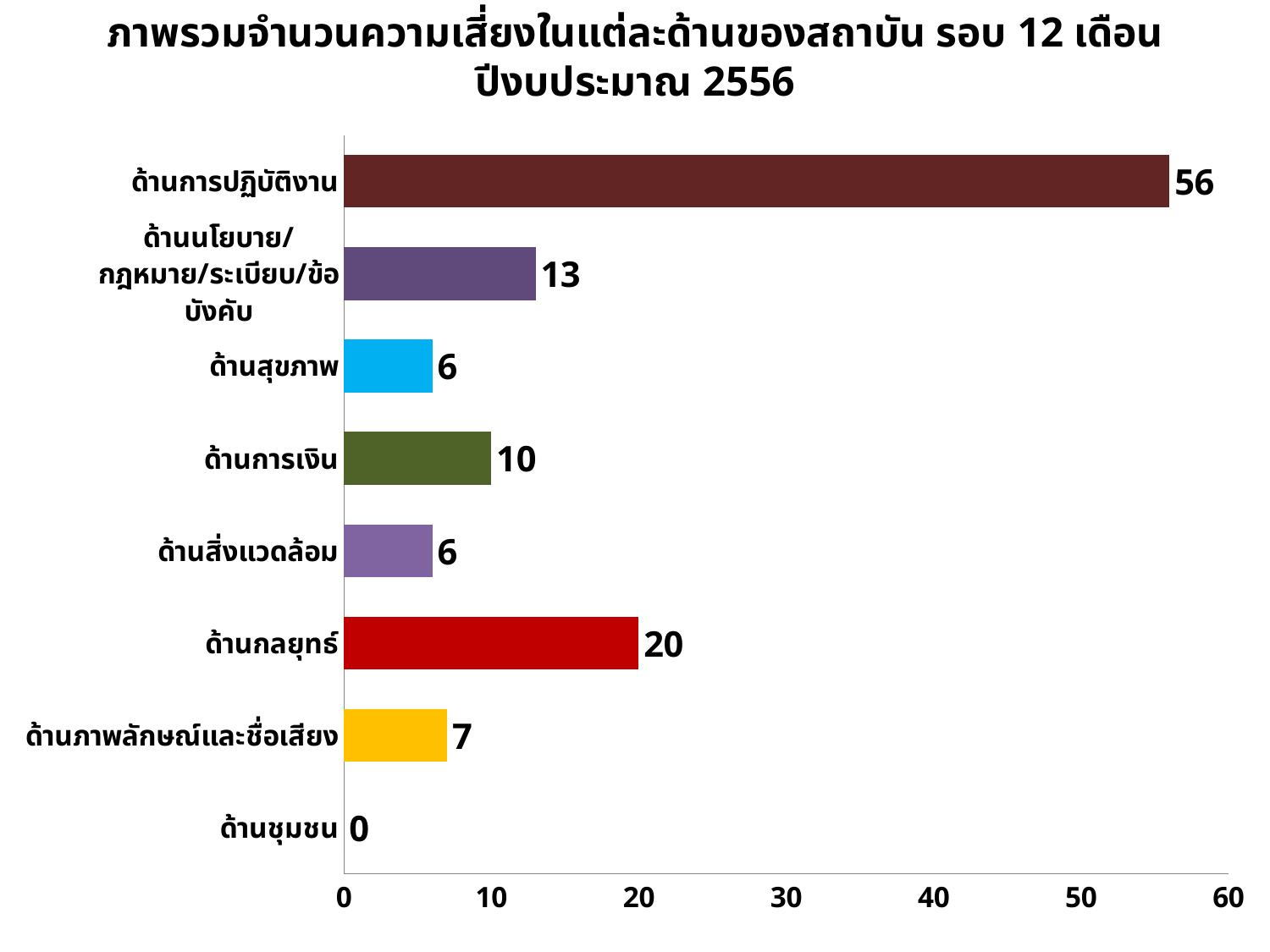
What is the value for ด้านชุมชน? 0 How many categories are shown in the chart? 8 Is the value for ด้านกลยุทธ์ greater or less than 10? greater What kind of chart is shown on the slide? bar chart What is the value for ด้านกลยุทธ์? 20 What is the title of the chart? ภาพรวมจำนวนความเสี่ยงในแต่ละด้านของสถาบัน รอบ 12 เดือน ปีงบประมาณ 2556 What is the value for ด้านนโยบาย/กฎหมาย/ระเบียบ/ข้อบังคับ? 13 What is the difference between the values for ด้านการปฏิบัติงาน and ด้านกลยุทธ์? 36 What is the value for ด้านการปฏิบัติงาน? 56 Which category has the lowest value? ด้านชุมชน Which is larger, the value for ด้านการเงิน or the value for ด้านภาพลักษณ์และชื่อเสียง? ด้านการเงิน Which category has the highest value? ด้านการปฏิบัติงาน